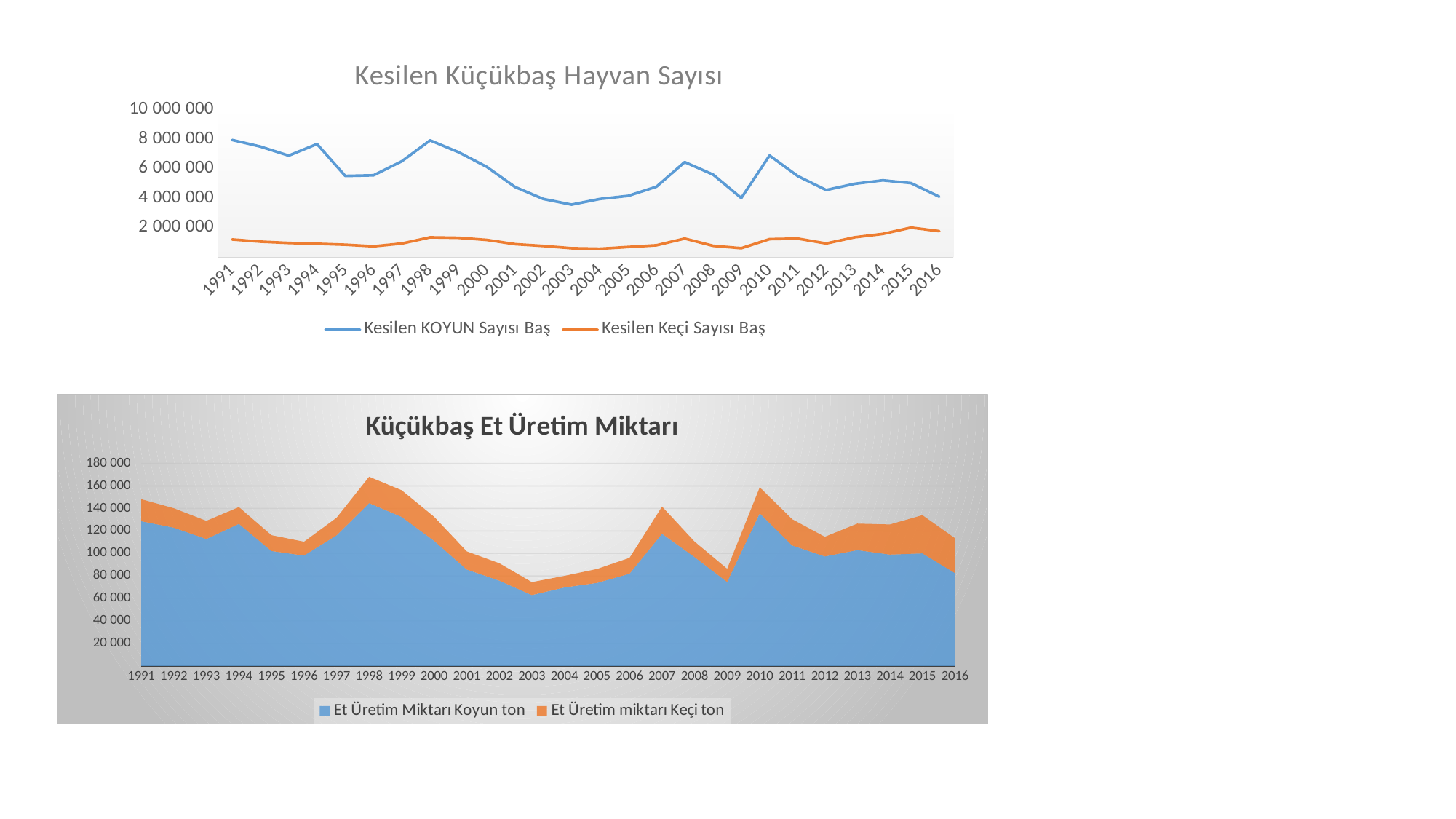
In the top chart 'Kesilen Küçükbaş Hayvan Sayısı', how many series does the legend list? 2 In the top chart 'Kesilen Küçükbaş Hayvan Sayısı', which is larger in 2016: 'Kesilen KOYUN Sayısı Baş' or 'Kesilen Keçi Sayısı Baş'? Kesilen KOYUN Sayısı Baş In the bottom chart 'Küçükbaş Et Üretim Miktarı', is the value for 'Et Üretim Miktarı Koyun ton' in 2003 greater or less than 80 000? less In the top chart 'Kesilen Küçükbaş Hayvan Sayısı', what kind of chart is it? line chart In the top chart 'Kesilen Küçükbaş Hayvan Sayısı', is the value for 'Kesilen KOYUN Sayısı Baş' in 2003 greater or less than 4 000 000? less In the bottom chart 'Küçükbaş Et Üretim Miktarı', what kind of chart is it? area chart In the bottom chart 'Küçükbaş Et Üretim Miktarı', which series is shown in orange? Et Üretim miktarı Keçi ton In the top chart 'Kesilen Küçükbaş Hayvan Sayısı', is the value for 'Kesilen KOYUN Sayısı Baş' in 1991 greater or less than 6 000 000? greater In the top chart 'Kesilen Küçükbaş Hayvan Sayısı', in which year is 'Kesilen Keçi Sayısı Baş' highest? 2015 In the bottom chart 'Küçükbaş Et Üretim Miktarı', in which year is 'Et Üretim Miktarı Koyun ton' highest? 1998 In the top chart 'Kesilen Küçükbaş Hayvan Sayısı', in which year is 'Kesilen KOYUN Sayısı Baş' lowest? 2003 In the top chart 'Kesilen Küçükbaş Hayvan Sayısı', how many years are shown on the x axis? 26